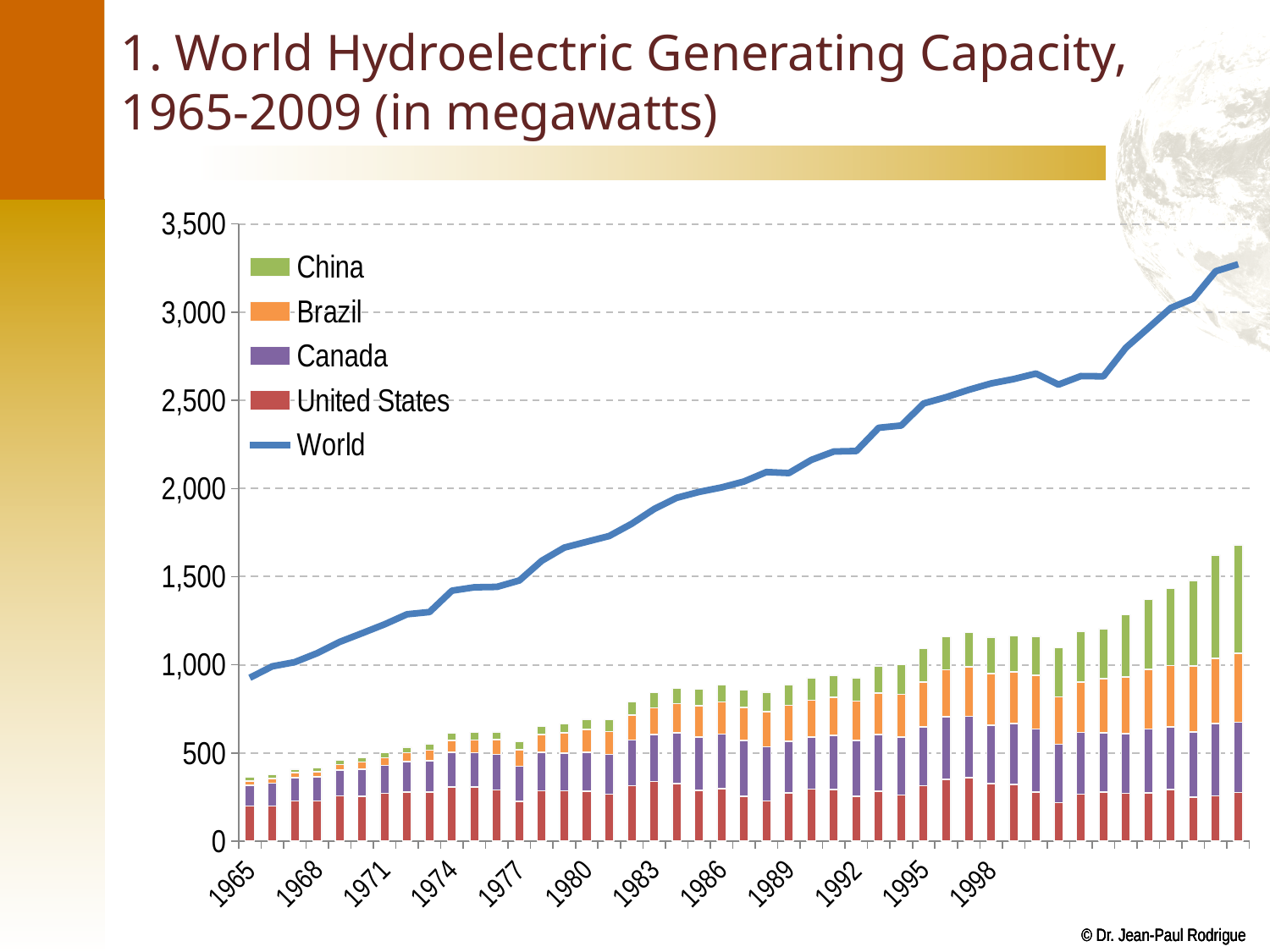
Is the World value in 1965 greater or less than 1,000? less In 1983, which is larger: the World line value or the total of the stacked bar? The World line value Does the World line rise or fall from 1965 to the end of the period? Rises Is the World value in 1980 greater or less than 1,500? greater Is the World value in 1998 greater or less than 2,500? greater Which series is shown in green in the legend? China Which series is plotted as a line rather than as bars? World What kind of chart is shown on the slide? A combined stacked bar and line chart How many series does the legend list? 5